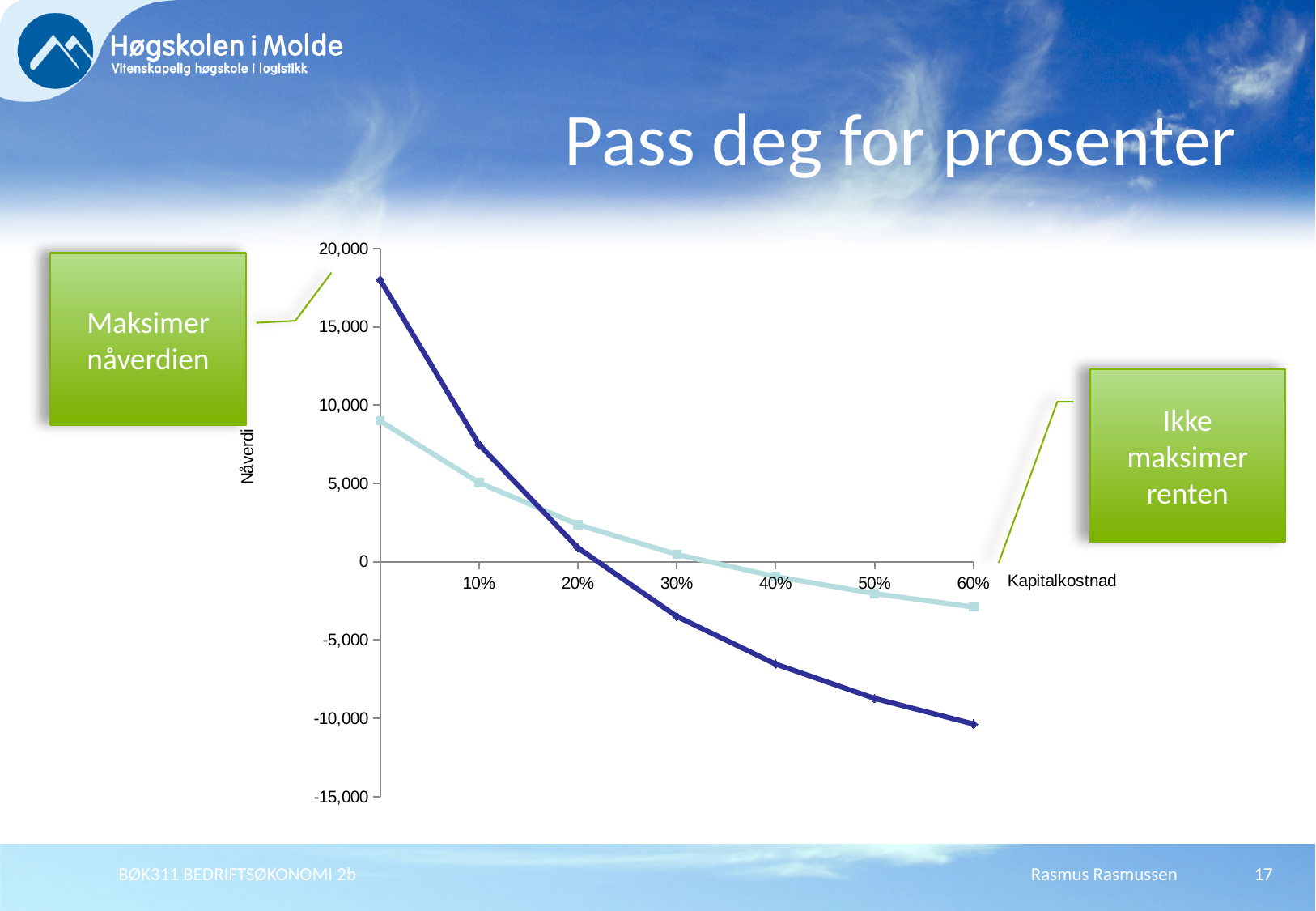
Is the value of the dark blue line at 30% greater or less than 0? less Do the values of the light blue line rise or fall as Kapitalkostnad increases? fall Is the value of the light blue line at 60% greater or less than -5,000? greater At 60%, which line has the higher value, the dark blue line or the light blue line? the light blue line What is the title of the x axis of the chart? Kapitalkostnad What kind of chart is shown on the slide? line chart How many lines are plotted on the chart? 2 How many percentage tick labels are shown on the x axis? 6 Do the values of the dark blue line rise or fall as Kapitalkostnad increases? fall Is the starting value of the dark blue line (at the left edge of the chart) greater or less than 15,000? greater